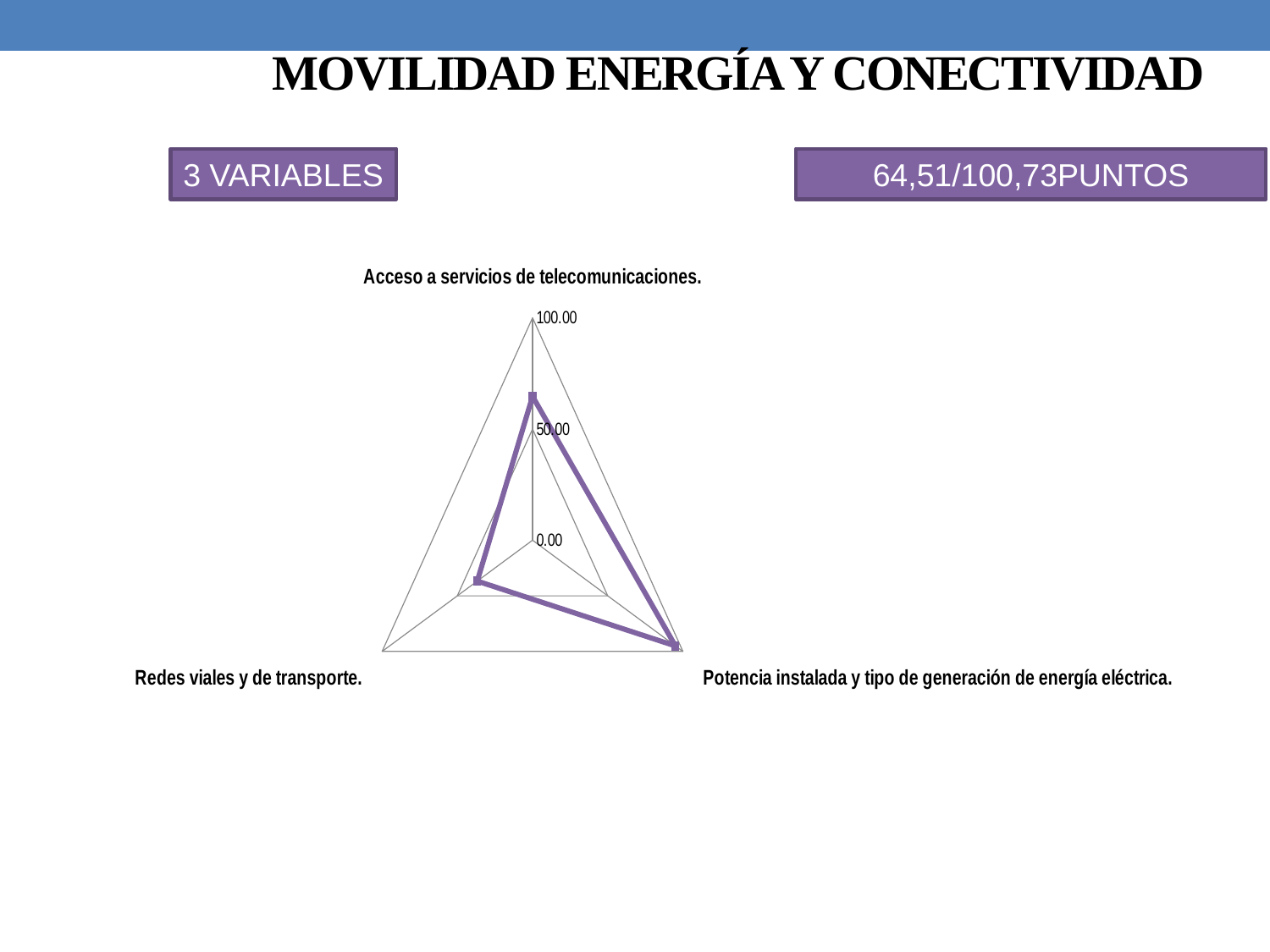
Is the value for Redes viales y de transporte greater or less than 50.00? less Which is larger: the value for Potencia instalada y tipo de generación de energía eléctrica or the value for Acceso a servicios de telecomunicaciones? Potencia instalada y tipo de generación de energía eléctrica. Which variable has the highest value on the radar chart? Potencia instalada y tipo de generación de energía eléctrica. Which is larger: the value for Acceso a servicios de telecomunicaciones or the value for Redes viales y de transporte? Acceso a servicios de telecomunicaciones. What colour is the data line plotted on the radar chart? Purple Is the value for Acceso a servicios de telecomunicaciones greater or less than 50.00? greater Is the value for Potencia instalada y tipo de generación de energía eléctrica greater or less than 50.00? greater Which variable has the lowest value on the radar chart? Redes viales y de transporte. How many variables (axes) does the radar chart have? 3 What is the maximum value shown on the radar chart's axis scale? 100.00 What kind of chart is shown on the slide? Radar chart